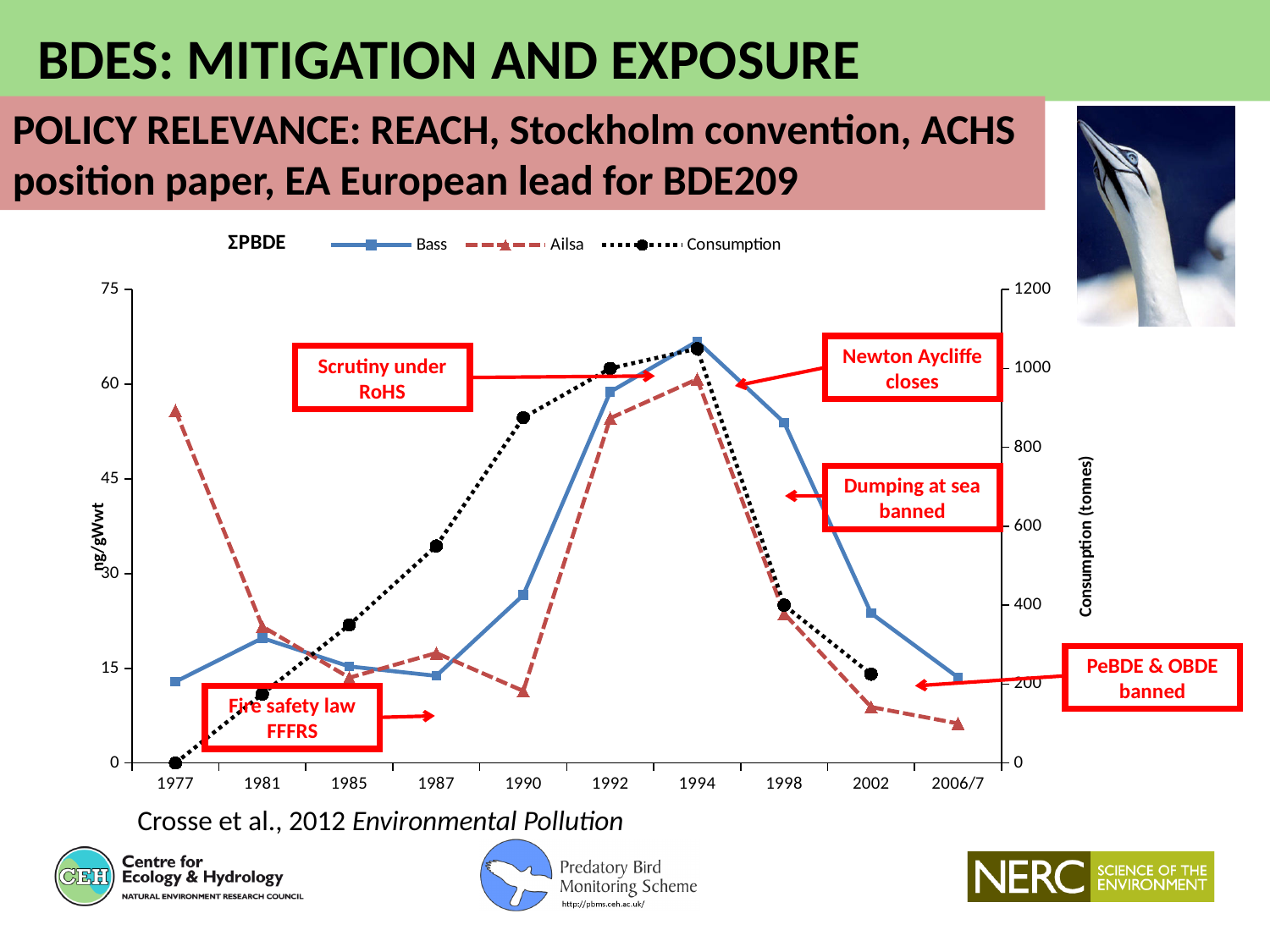
Which series has the higher value in 1998, Bass or Ailsa? Bass What kind of chart is shown on the slide? line chart In which year does the Bass series reach its highest value? 1994 How many years are shown along the x axis of the chart? 10 Do the Bass values rise or fall from 1994 to 2006/7? fall How many series does the chart legend list? 3 Is the Bass value in 1994 greater or less than 60? greater What is the label on the right-hand vertical axis of the chart? Consumption (tonnes) Is the Consumption value in 1992 greater or less than 800? greater In which year is the Consumption series at its lowest? 1977 In which year does the Consumption series reach its highest value? 1994 Is the Ailsa value in 1990 greater or less than 15? less